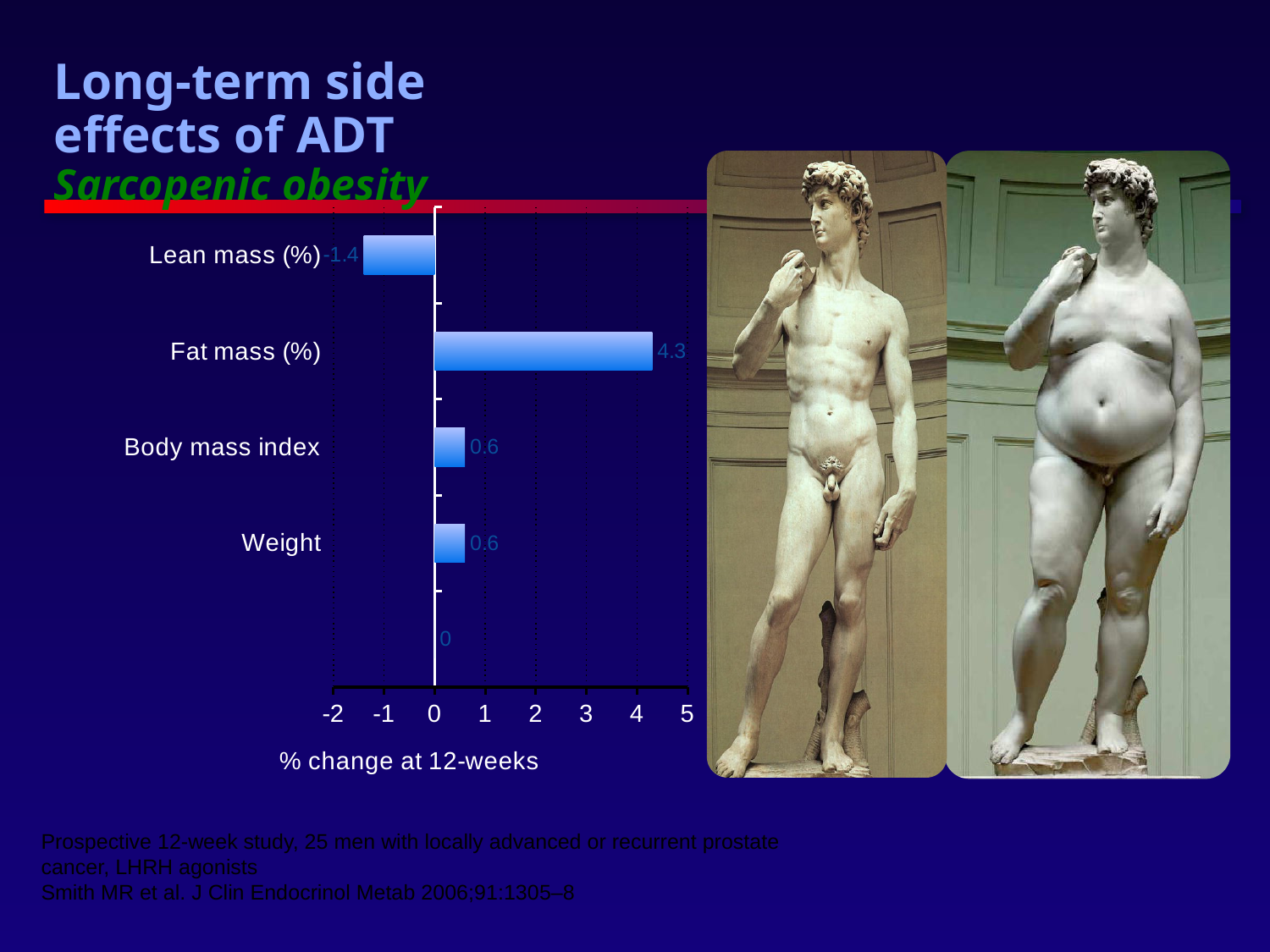
What is the value for Lean mass (%) in the bar chart? -1.4 Which is larger, the value for Fat mass (%) or the value for Weight? Fat mass (%) What is the value for Fat mass (%) in the bar chart? 4.3 What is the value for Body mass index in the bar chart? 0.6 What is the value for Weight in the bar chart? 0.6 What is the difference between the values for Fat mass (%) and Body mass index? 3.7 What is the title of the horizontal axis of the bar chart? % change at 12-weeks What is the difference between the values for Fat mass (%) and Lean mass (%)? 5.7 Which category has the highest value in the bar chart? Fat mass (%) What kind of chart is shown on the slide? bar chart Is the value for Lean mass (%) greater or less than 0? less Which category has the lowest value in the bar chart? Lean mass (%)